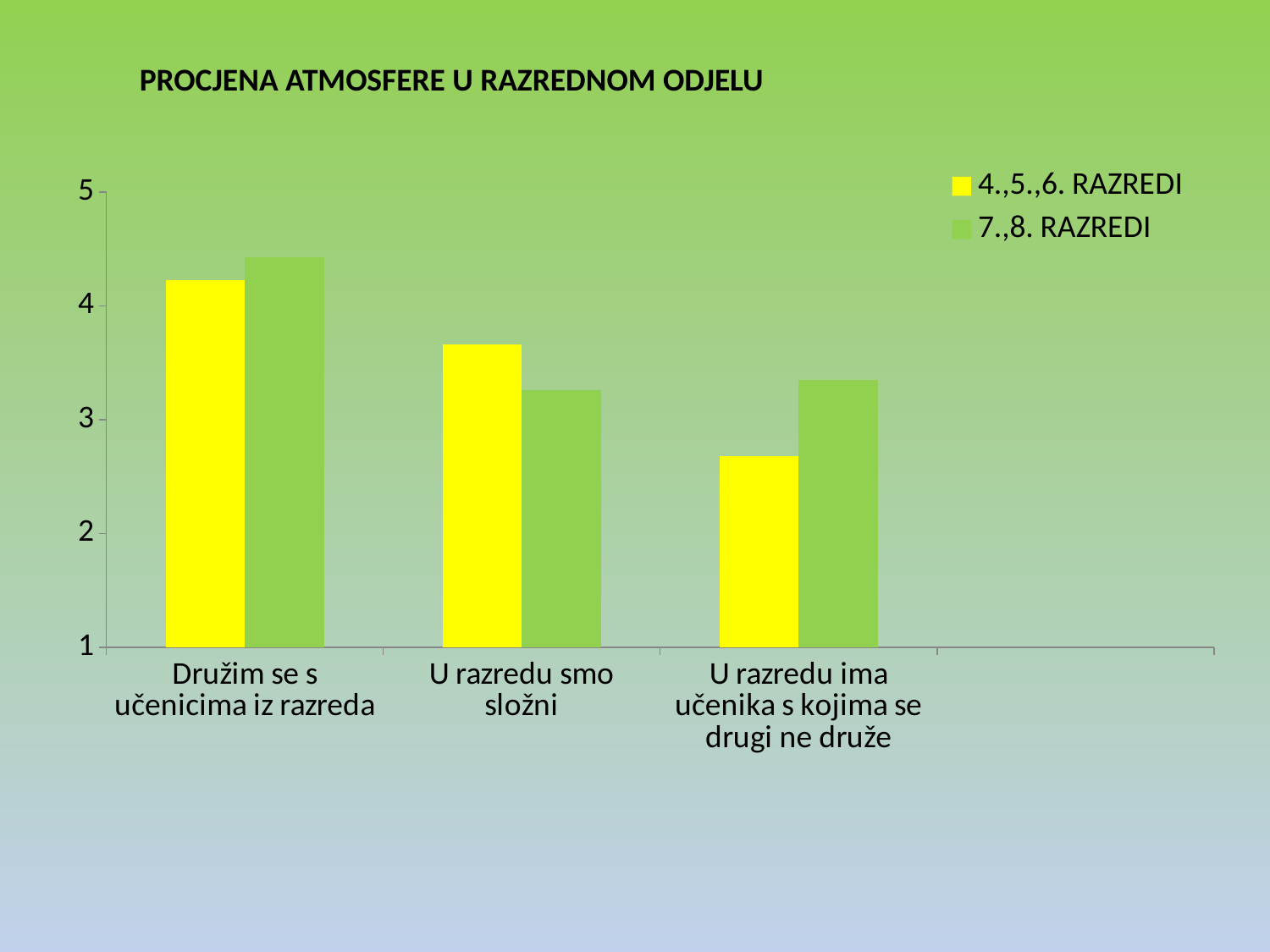
Is the value for 4.,5.,6. RAZREDI in the category 'U razredu ima učenika s kojima se drugi ne druže' greater or less than 3? less What kind of chart is shown on the slide? bar chart Which series is shown in yellow in the legend? 4.,5.,6. RAZREDI How many series does the legend list? 2 Is the value for 4.,5.,6. RAZREDI in the category 'Družim se s učenicima iz razreda' greater or less than 4? greater Is the value for 7.,8. RAZREDI in the category 'U razredu ima učenika s kojima se drugi ne druže' greater or less than 3? greater In the category 'U razredu smo složni', which series has the larger value, 4.,5.,6. RAZREDI or 7.,8. RAZREDI? 4.,5.,6. RAZREDI For the series 4.,5.,6. RAZREDI, which category has the lowest value? U razredu ima učenika s kojima se drugi ne druže In the category 'U razredu ima učenika s kojima se drugi ne druže', which series has the larger value, 4.,5.,6. RAZREDI or 7.,8. RAZREDI? 7.,8. RAZREDI How many categories are shown on the x axis of the chart? 3 What is the title of the chart? PROCJENA ATMOSFERE U RAZREDNOM ODJELU